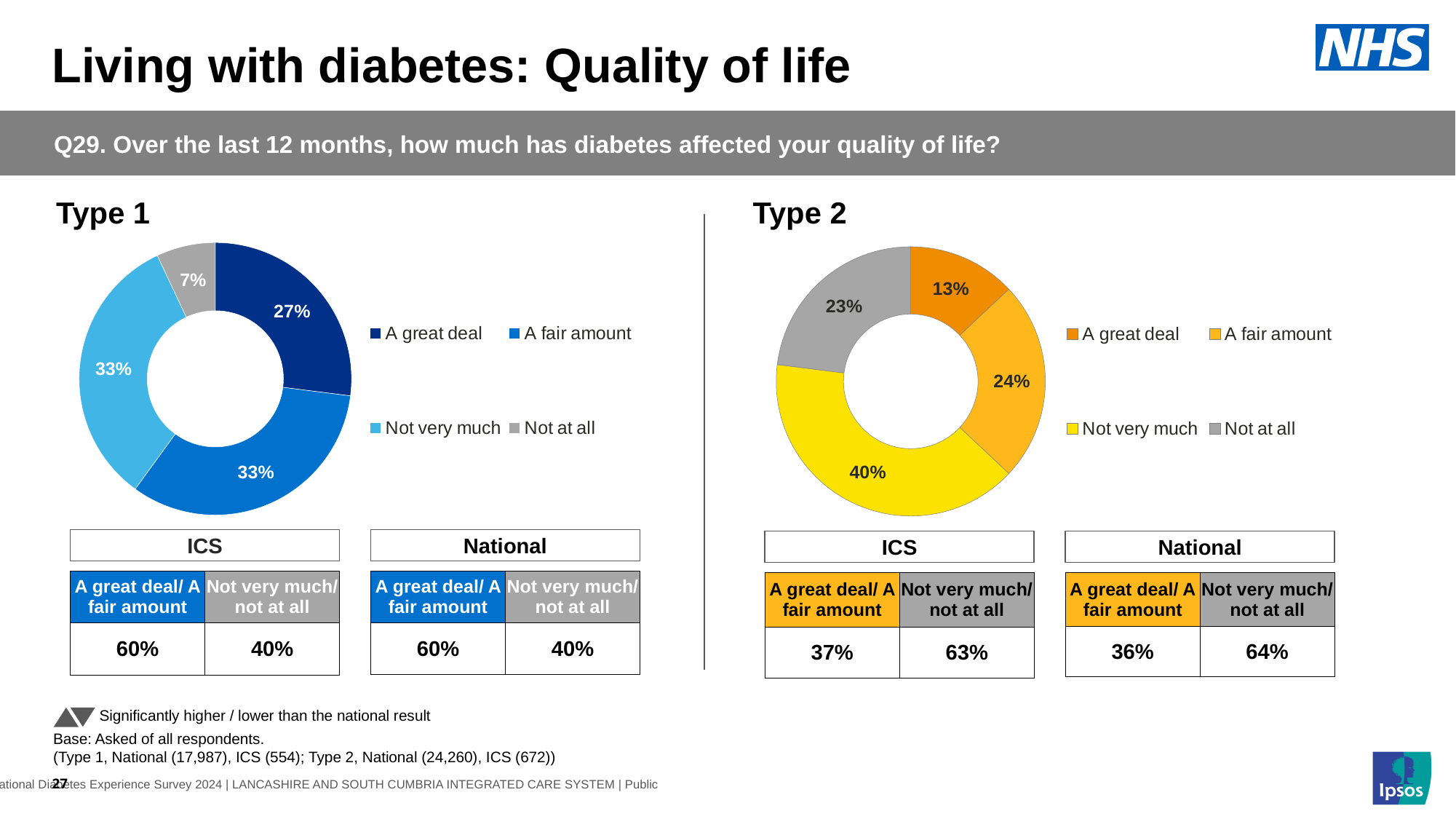
Which is larger in the Type 2 chart: 'A great deal' or 'Not at all'? Not at all In the Type 2 chart, what percentage is shown for 'Not very much'? 40% In the Type 2 chart, what is the difference in percentage points between 'Not very much' and 'Not at all'? 17 How many categories does the legend of the Type 1 chart list? 4 In the Type 1 chart, what is the difference in percentage points between 'A great deal' and 'Not at all'? 20 In the Type 2 chart, which category has the smallest share? A great deal What kind of chart is used for Type 2? Doughnut (pie) chart In the Type 2 chart, what percentage is shown for 'A fair amount'? 24% In the Type 1 chart, what percentage is shown for 'Not at all'? 7% In the Type 2 chart, which category has the largest share? Not very much In the Type 1 chart, what percentage of respondents said diabetes affected their quality of life 'A great deal'? 27% In the Type 1 chart, which category has the smallest share? Not at all